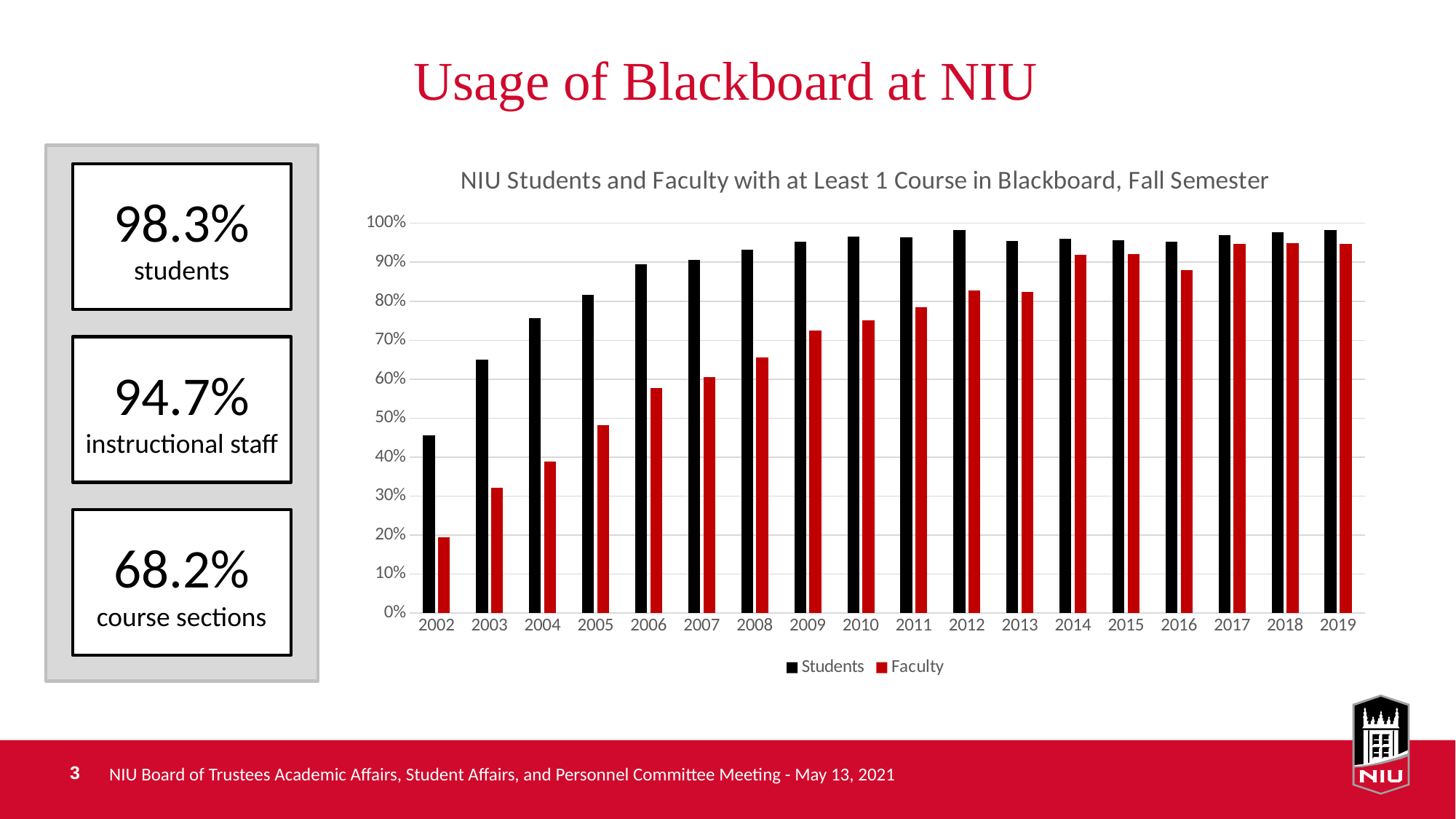
What kind of chart is shown on the slide? bar chart How many series does the chart legend list? 2 Does the Faculty series generally rise or fall from 2002 to 2019? rise In 2002, which series has the larger value, Students or Faculty? Students Is the value for Students in 2012 greater or less than 90%? greater Is the value for Faculty in 2002 greater or less than 30%? less Is the value for Students in 2002 greater or less than 50%? less Which year has the lowest value for the Faculty series? 2002 Which year has the lowest value for the Students series? 2002 How many years are shown on the x axis of the chart? 18